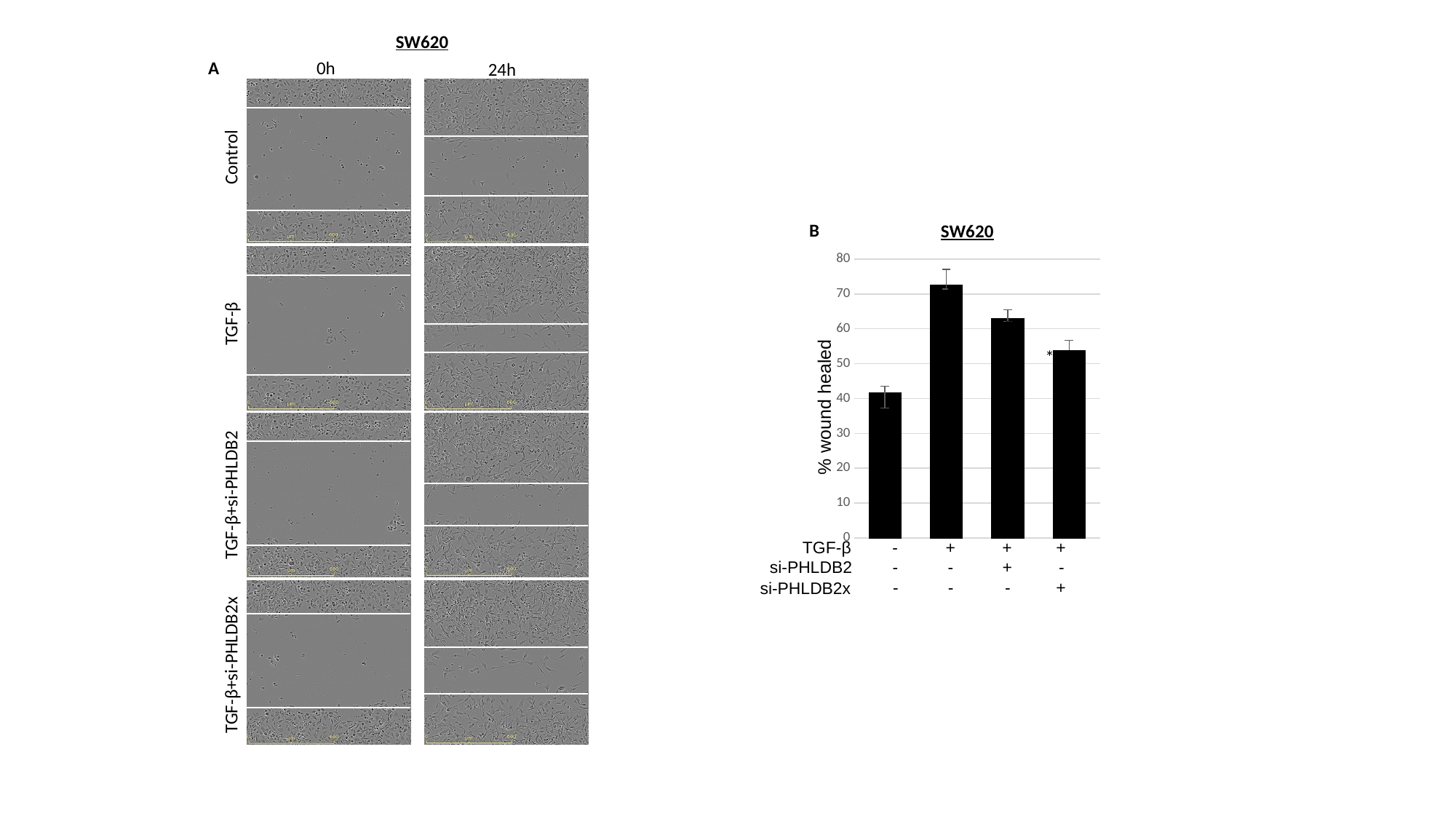
In the panel B chart, which condition has the highest % wound healed? TGF-β + (si-PHLDB2 -, si-PHLDB2x -) In the panel B chart, is the % wound healed for the first bar (TGF-β -, si-PHLDB2 -, si-PHLDB2x -) greater or less than 50? less In the panel B chart, do the bars rise or fall from the second bar (TGF-β only) to the fourth bar (TGF-β + si-PHLDB2x)? fall What is the title of the chart in panel B? SW620 What is the y-axis label of the chart in panel B? % wound healed What kind of chart is shown in panel B of the slide? bar chart In the panel B chart, is the % wound healed for the TGF-β + si-PHLDB2 condition greater or less than 60? greater In the panel B chart, is the % wound healed for the TGF-β + si-PHLDB2x condition greater or less than 60? less In the panel B chart, which condition has the lowest % wound healed? Control (TGF-β -, si-PHLDB2 -, si-PHLDB2x -) How many bars are plotted in the panel B chart? 4 In the panel B chart, which has a higher % wound healed: the TGF-β + si-PHLDB2 condition or the TGF-β + si-PHLDB2x condition? TGF-β + si-PHLDB2